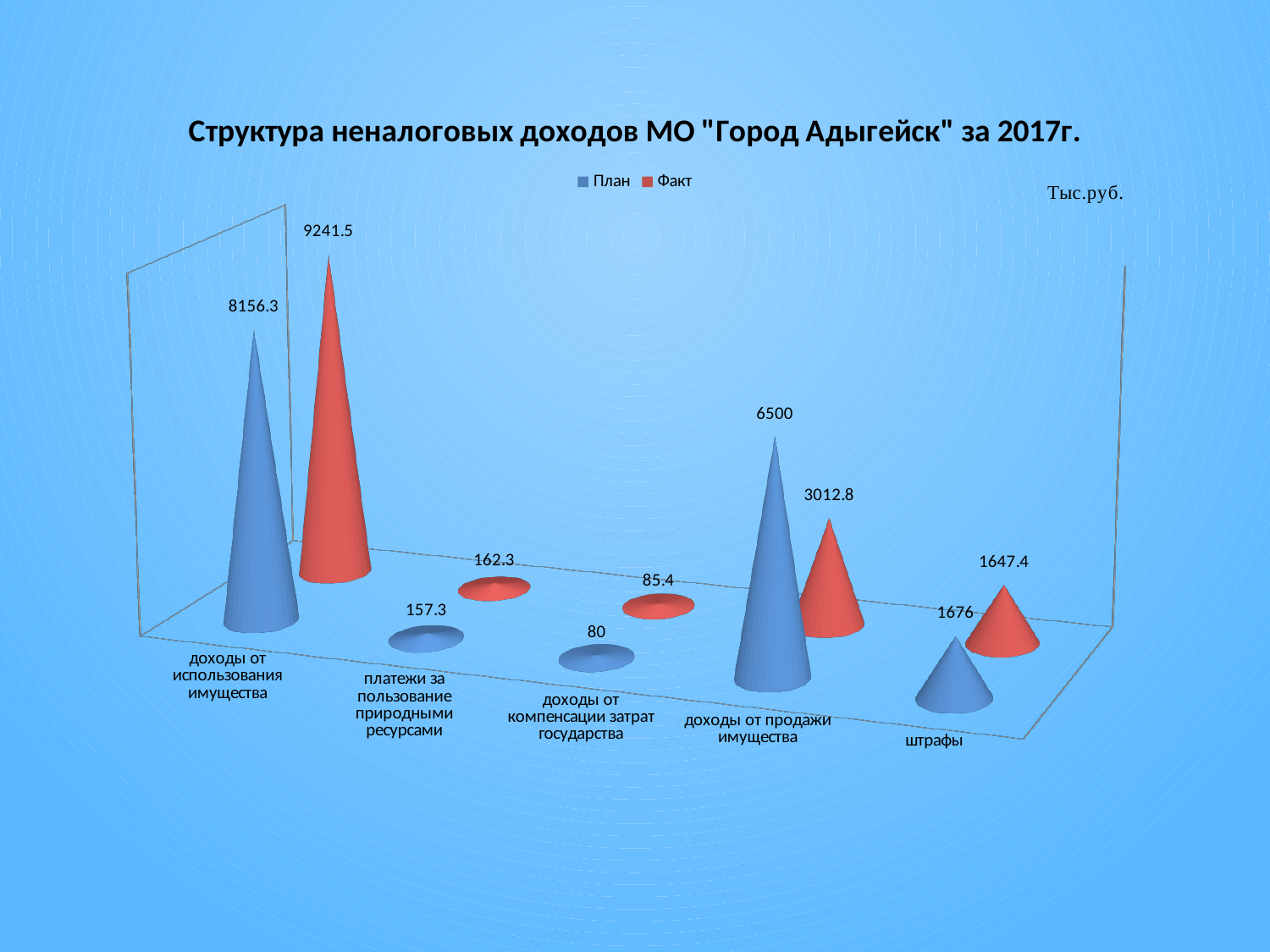
Which is larger for "штрафы": the План value or the Факт value? План How many categories are shown on the x axis? 5 What is the Факт value for "штрафы"? 1647.4 What is the План value for "доходы от компенсации затрат государства"? 80 What is the План value for "доходы от использования имущества"? 8156.3 Which category has the lowest План value? доходы от компенсации затрат государства Which category has the highest Факт value? доходы от использования имущества What is the difference between the Факт and План values for "доходы от использования имущества"? 1085.2 How many series does the legend list? 2 What is the difference between the План and Факт values for "доходы от продажи имущества"? 3487.2 What is the Факт value for "доходы от продажи имущества"? 3012.8 What unit is indicated for the values on the chart? Тыс.руб.